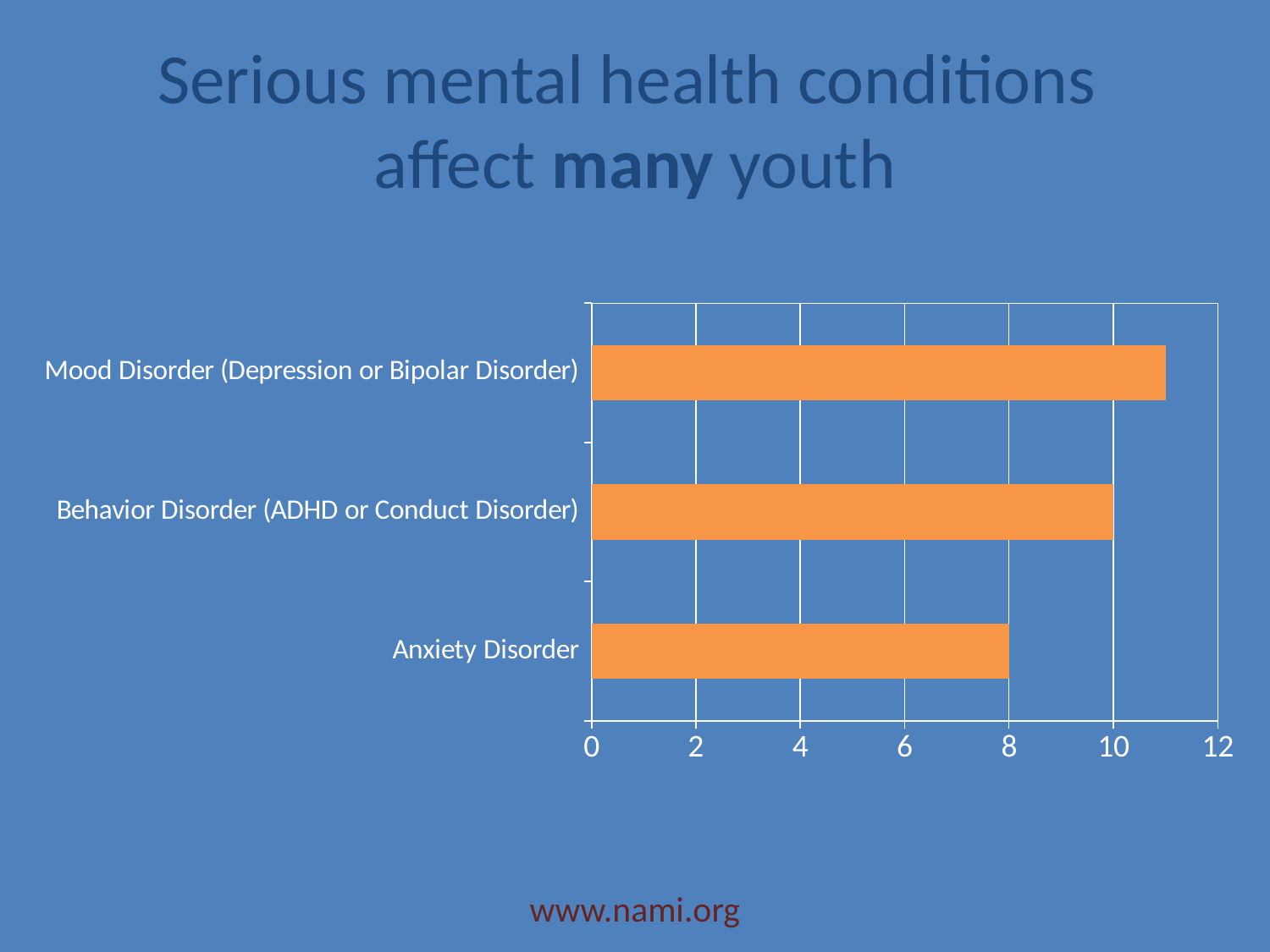
How many categories are plotted in the chart? 3 Which category has the highest value in the chart? Mood Disorder (Depression or Bipolar Disorder) Which is larger, the value for Mood Disorder (Depression or Bipolar Disorder) or the value for Anxiety Disorder? Mood Disorder (Depression or Bipolar Disorder) What is the title of the slide containing the chart? Serious mental health conditions affect many youth Which category has the lowest value in the chart? Anxiety Disorder What kind of chart is shown on the slide? bar chart What colour are the bars in the chart? orange Is the value for Mood Disorder (Depression or Bipolar Disorder) greater or less than 10? greater What is the difference between the values for Behavior Disorder (ADHD or Conduct Disorder) and Anxiety Disorder? 2 Is the value for Anxiety Disorder greater or less than 6? greater What is the value for Anxiety Disorder? 8 What is the value for Behavior Disorder (ADHD or Conduct Disorder)? 10